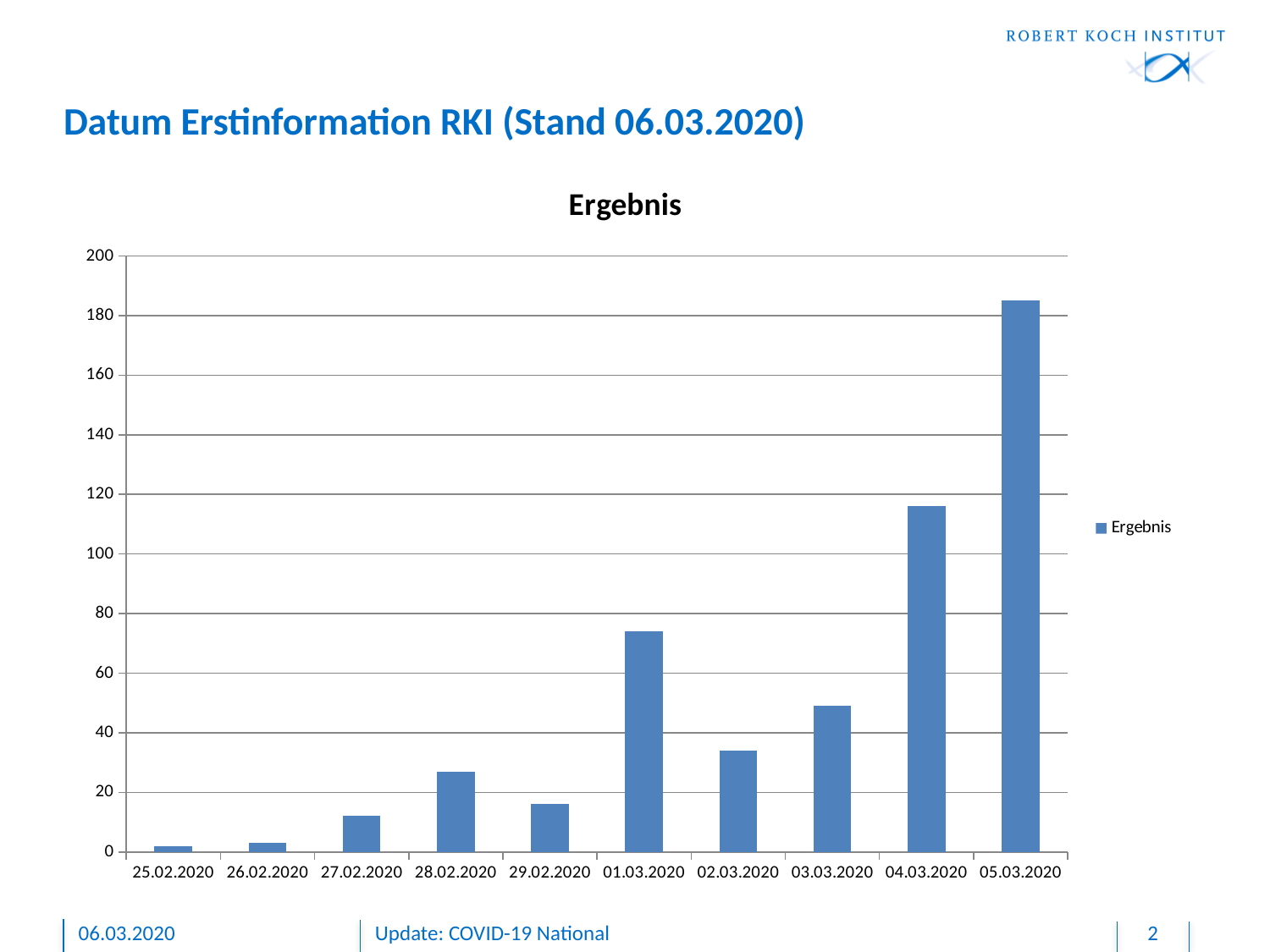
Which date has the highest value in the chart? 05.03.2020 What kind of chart is shown on the slide? bar chart Is the value for 04.03.2020 greater or less than 100? greater Is the value for 01.03.2020 greater or less than 80? less Do the values generally rise or fall from 25.02.2020 to 05.03.2020? rise How many dates are shown on the x axis of the chart? 10 How many series does the legend list? 1 Is the value for 03.03.2020 greater or less than 40? greater What is the title of the chart? Ergebnis Which has the larger value, 01.03.2020 or 02.03.2020? 01.03.2020